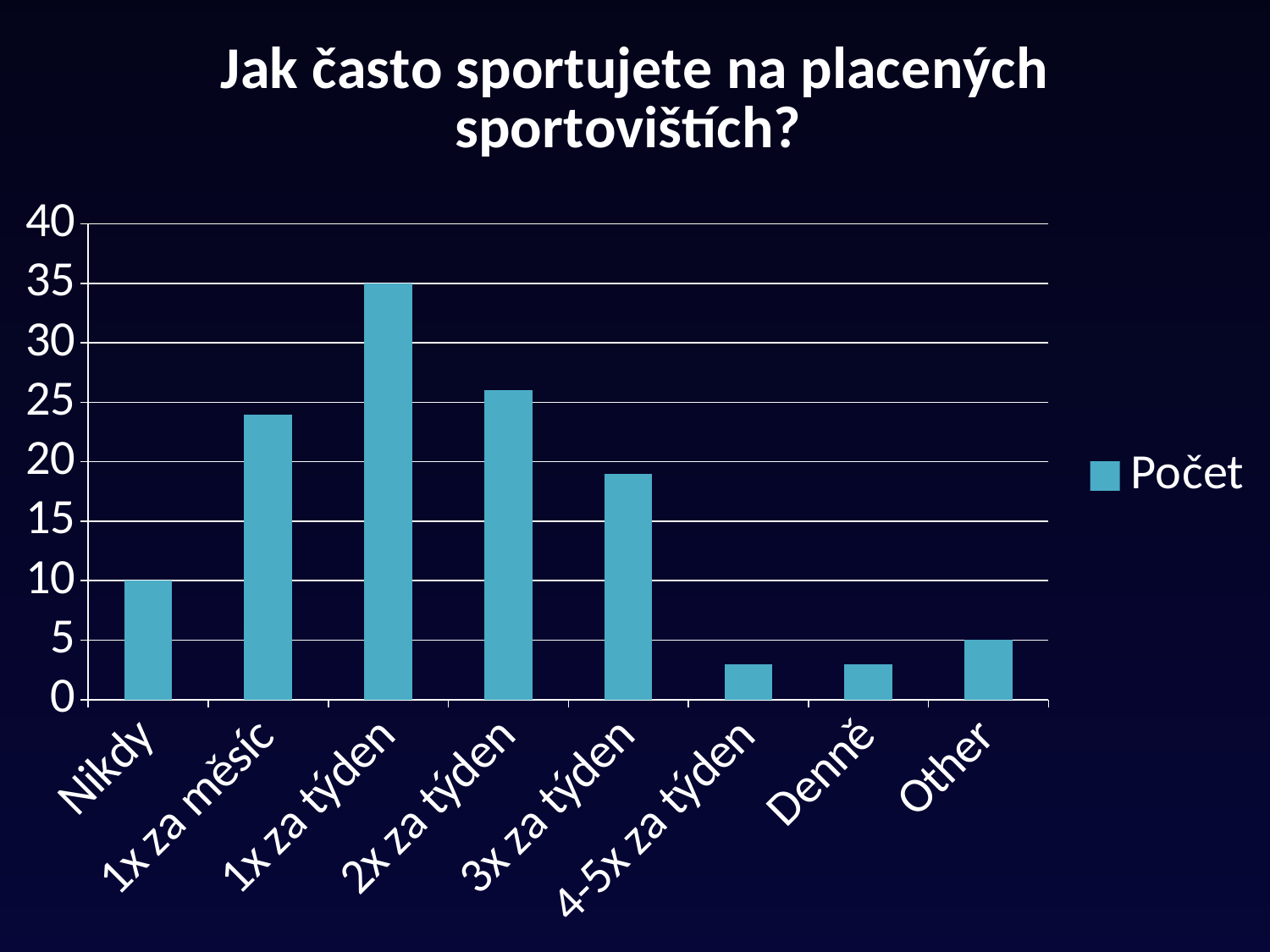
How many categories are shown on the x axis of the chart? 8 What is the value for Nikdy? 10 Which category has the highest value? 1x za týden What is the difference between the values for 1x za týden and Nikdy? 25 What is the value for 1x za týden? 35 What is the value for Other? 5 Is the value for 1x za měsíc greater or less than 20? greater How many series does the legend list? 1 Which is larger, the value for 1x za měsíc or the value for 3x za týden? 1x za měsíc What is the name of the series shown in the legend? Počet What type of chart is shown on the slide? bar chart Is the value for Denně greater or less than 5? less